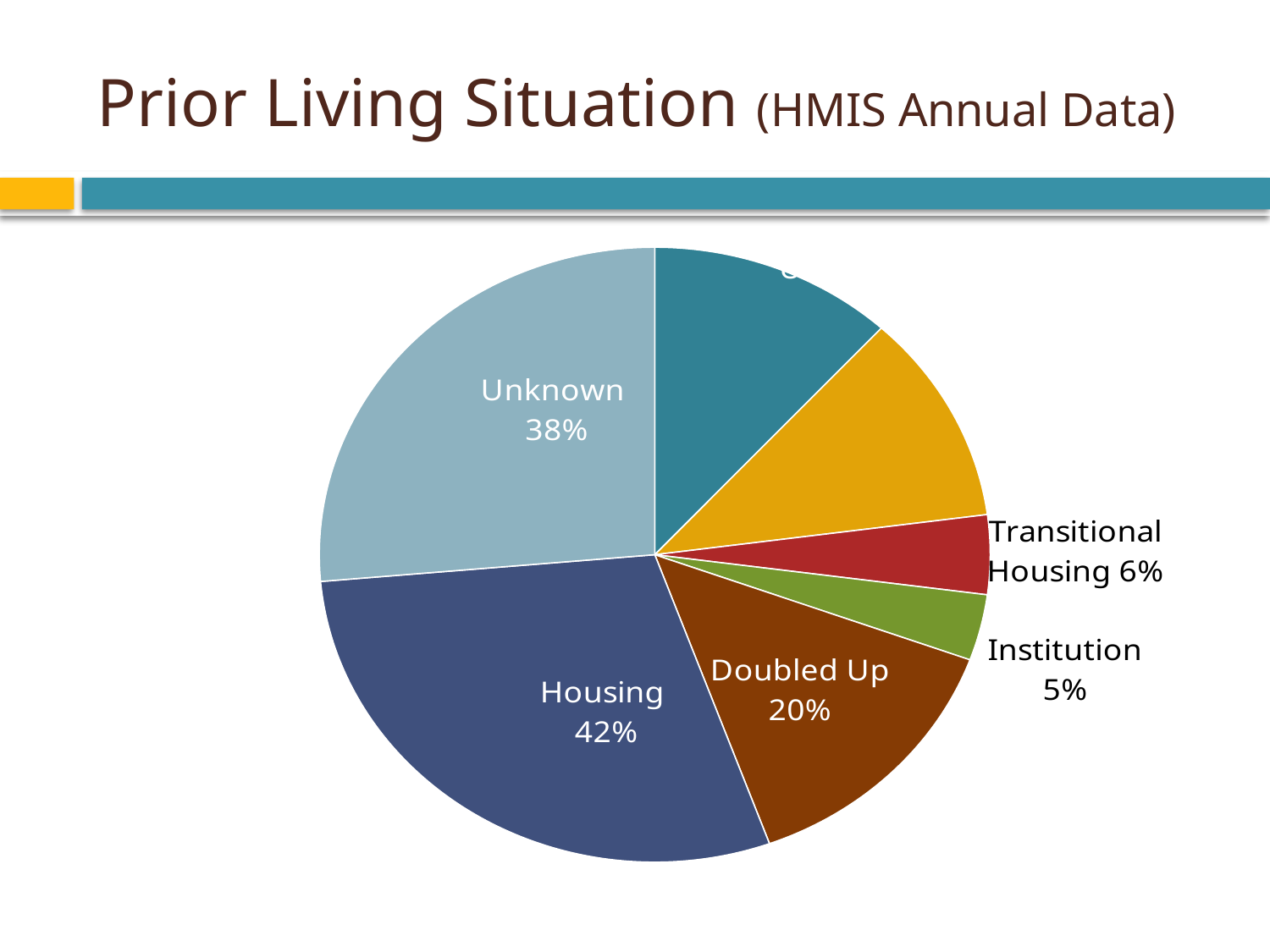
What percentage is shown for Doubled Up? 20% How many slices does the pie chart have? 7 What percentage of the pie is labelled Housing? 42% What percentage is shown for Transitional Housing? 6% What percentage is shown for the Unknown slice? 38% By how many percentage points does Housing exceed Unknown? 4 percentage points Which labelled slice has the smallest share of the pie? Institution Which is larger, the Doubled Up slice or the Unknown slice? Unknown What percentage is shown for Institution? 5% What is the title of the slide? Prior Living Situation (HMIS Annual Data) Which labelled slice has the largest share of the pie? Housing What kind of chart is shown on the slide? pie chart